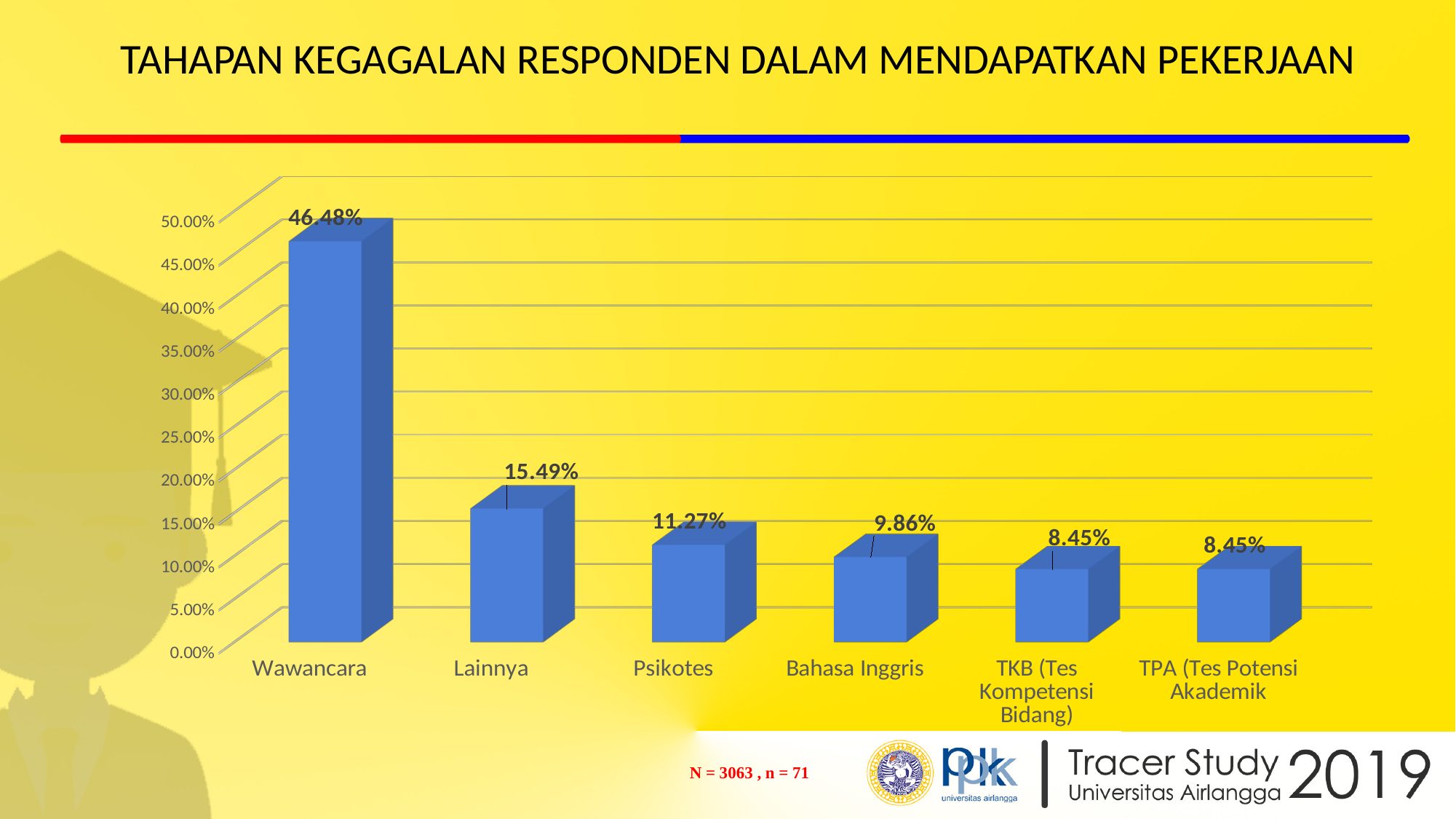
What is the value for Lainnya? 15.49% Do the values rise or fall from left to right along the x axis? Fall Which category has the highest value? Wawancara How many categories are shown on the x axis? 6 What is the difference between the values for Lainnya and Psikotes? 4.22% What kind of chart is shown on the slide? Bar chart What is the value for Psikotes? 11.27% Which is larger, the value for Psikotes or the value for Bahasa Inggris? Psikotes What is the value for Wawancara? 46.48% What is the difference between the values for Wawancara and Lainnya? 30.99% What is the value for TKB (Tes Kompetensi Bidang)? 8.45% What is the value for Bahasa Inggris? 9.86%